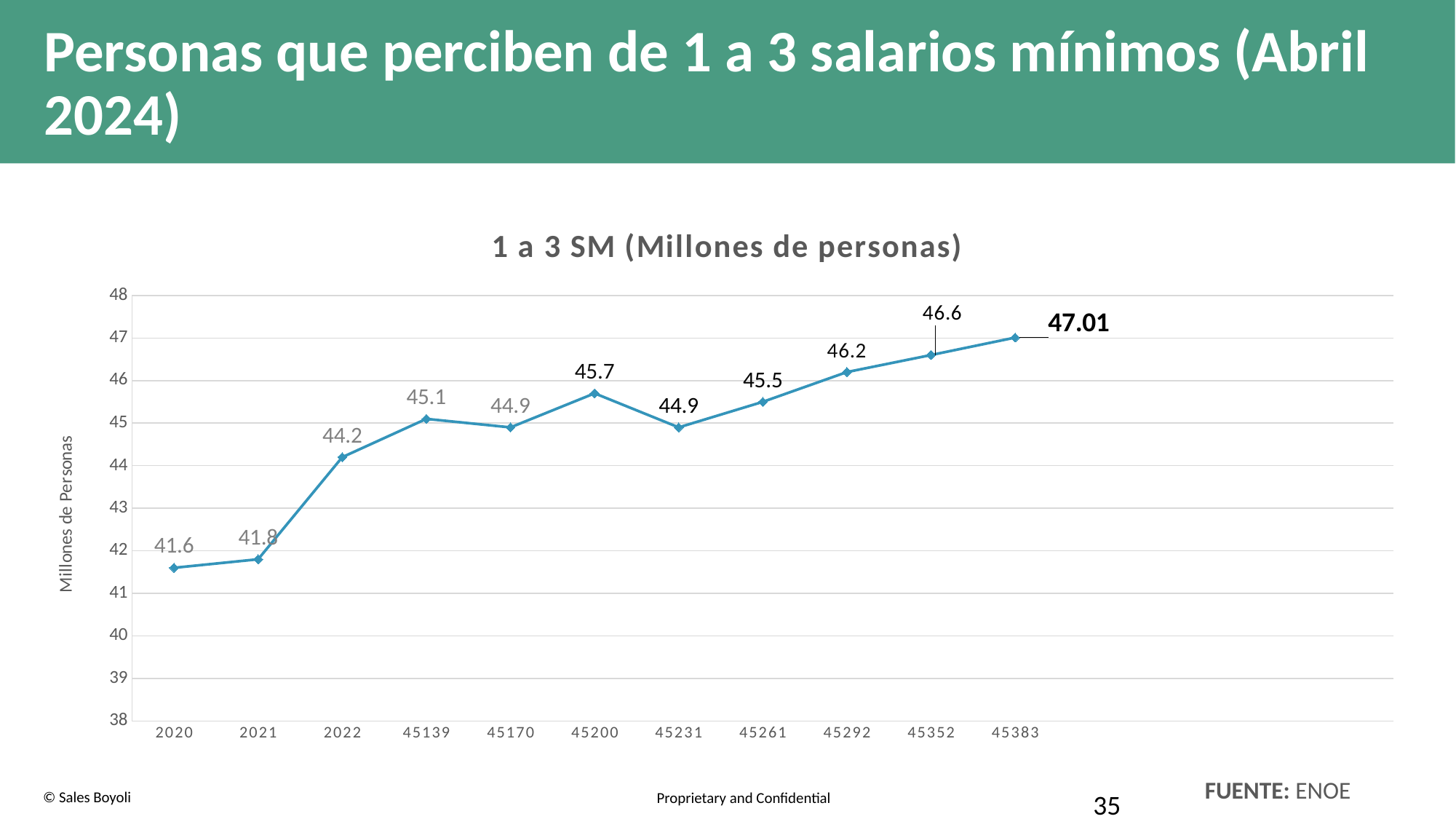
What is the title of the chart? 1 a 3 SM (Millones de personas) Which category has the lowest value? 2020 What is the difference between the values for 2022 and 2021? 2.4 Do the values generally rise or fall from 2020 to 45383? rise What kind of chart is shown on the slide? line chart What is the value for the last point, labelled 45383? 47.01 What is the value for the point labelled 45200? 45.7 What is the value for 2022? 44.2 What is the value for 2020? 41.6 Which category has the highest value? 45383 How many data points are plotted on the chart? 11 Which is larger, the value for 45200 or the value for 45231? 45200